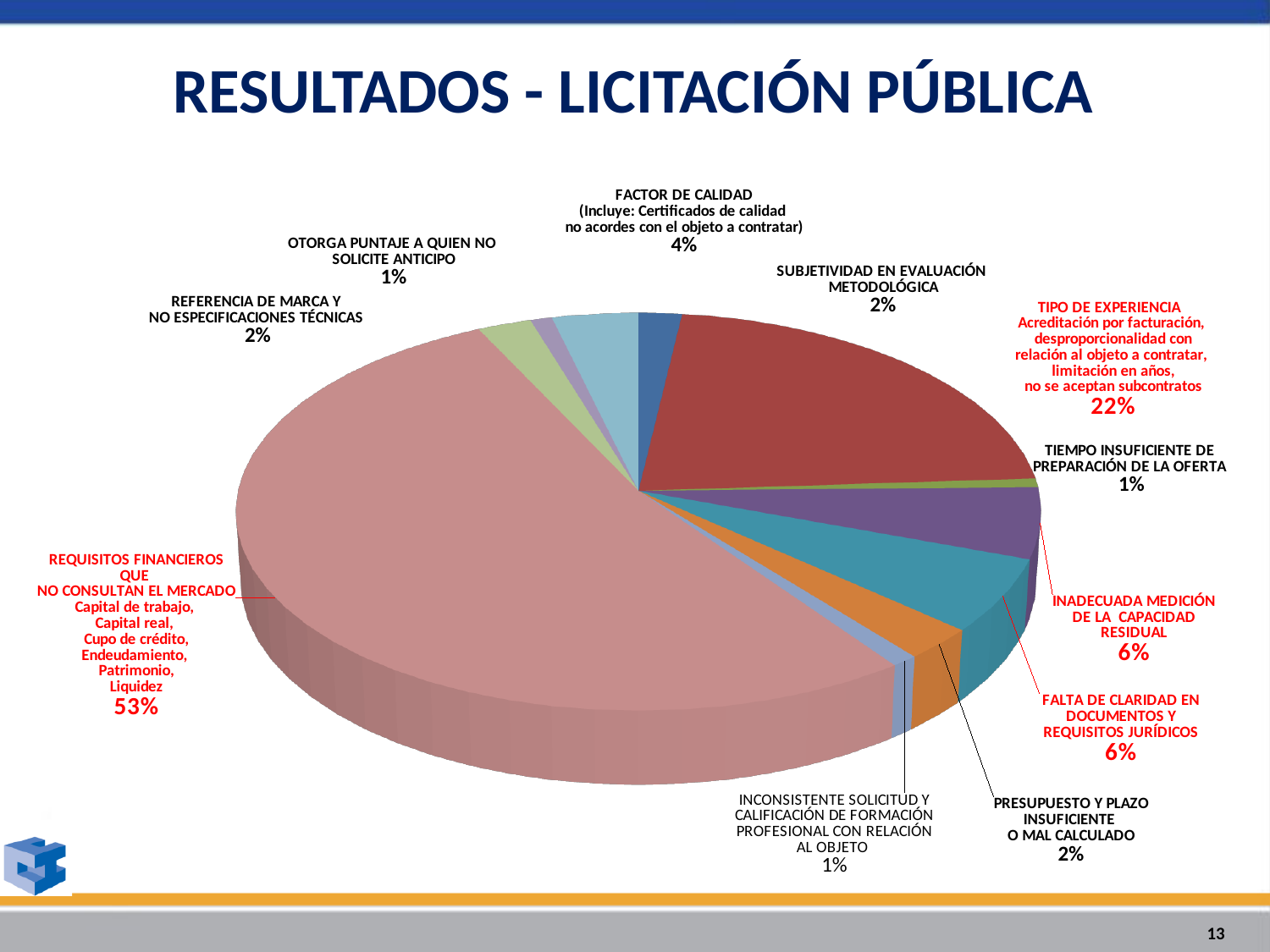
Which category has the largest share of the pie? REQUISITOS FINANCIEROS QUE NO CONSULTAN EL MERCADO What percentage is shown for PRESUPUESTO Y PLAZO INSUFICIENTE O MAL CALCULADO? 2% What percentage is shown for REQUISITOS FINANCIEROS QUE NO CONSULTAN EL MERCADO? 53% What percentage is shown for TIPO DE EXPERIENCIA? 22% What is the combined share of INADECUADA MEDICIÓN DE LA CAPACIDAD RESIDUAL and FALTA DE CLARIDAD EN DOCUMENTOS Y REQUISITOS JURÍDICOS? 12% Which is larger: the share for FACTOR DE CALIDAD or the share for FALTA DE CLARIDAD EN DOCUMENTOS Y REQUISITOS JURÍDICOS? FALTA DE CLARIDAD EN DOCUMENTOS Y REQUISITOS JURÍDICOS What is the title of the slide containing the chart? RESULTADOS - LICITACIÓN PÚBLICA What percentage is shown for INADECUADA MEDICIÓN DE LA CAPACIDAD RESIDUAL? 6% How many slices does the pie chart have? 11 What is the difference in percentage points between REQUISITOS FINANCIEROS QUE NO CONSULTAN EL MERCADO and TIPO DE EXPERIENCIA? 31 What type of chart is shown on the slide? pie chart What percentage is shown for FACTOR DE CALIDAD? 4%